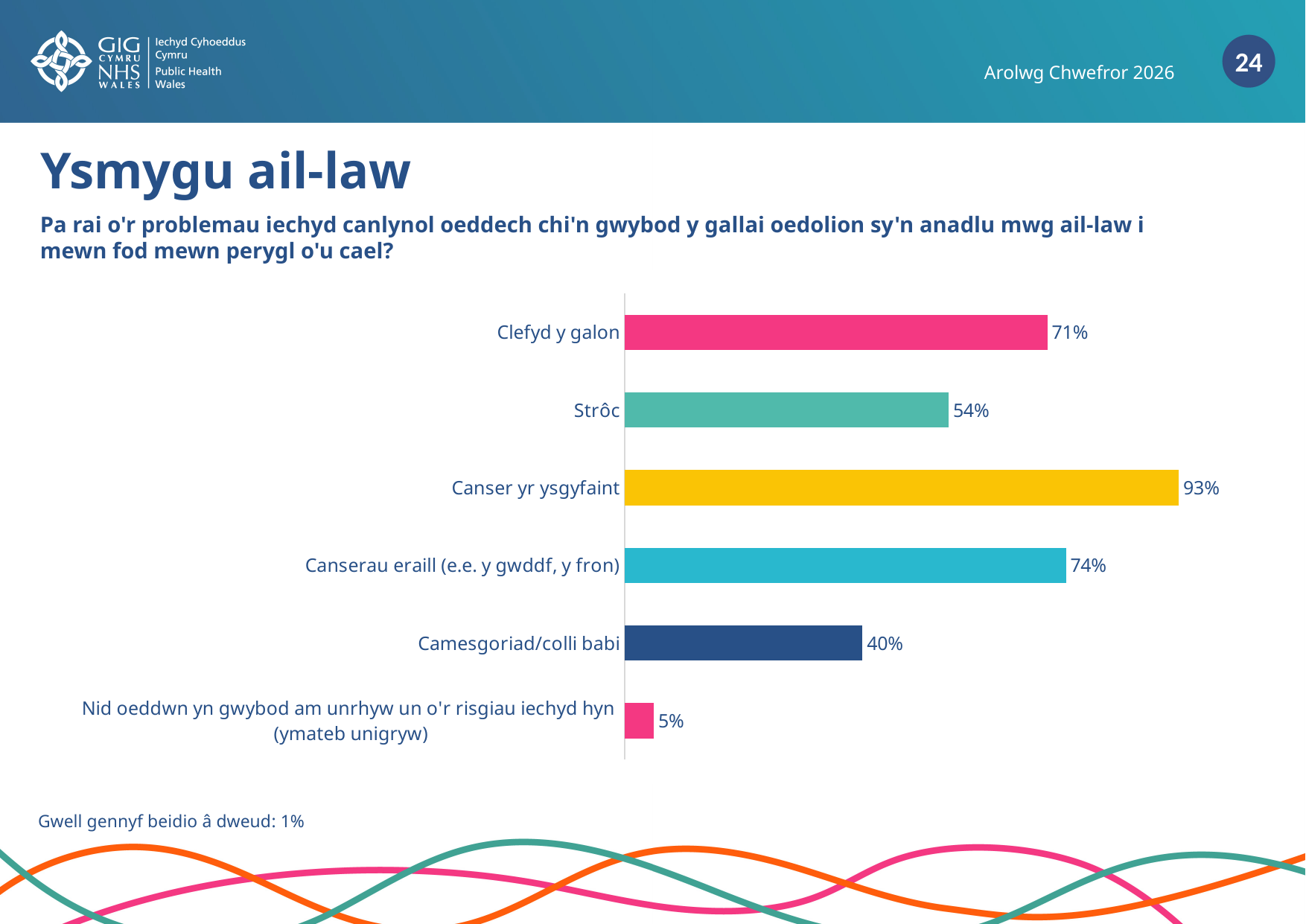
How many categories are shown on the chart? 6 Which health problem has the highest percentage on the chart? Canser yr ysgyfaint What percentage of respondents knew that lung cancer (Canser yr ysgyfaint) is a risk of breathing second-hand smoke? 93% What percentage is given for 'Gwell gennyf beidio â dweud' in the note below the chart? 1% What is the difference in percentage points between Canser yr ysgyfaint and Canserau eraill (e.e. y gwddf, y fron)? 19 What is the value shown for Clefyd y galon? 71% Which is larger, the value for Clefyd y galon or the value for Strôc? Clefyd y galon What is the value shown for Camesgoriad/colli babi? 40% Which category has the lowest percentage on the chart? Nid oeddwn yn gwybod am unrhyw un o'r risgiau iechyd hyn (ymateb unigryw) What is the value shown for Strôc? 54% What kind of chart is shown on the slide? Bar chart What is the difference in percentage points between Clefyd y galon and Camesgoriad/colli babi? 31